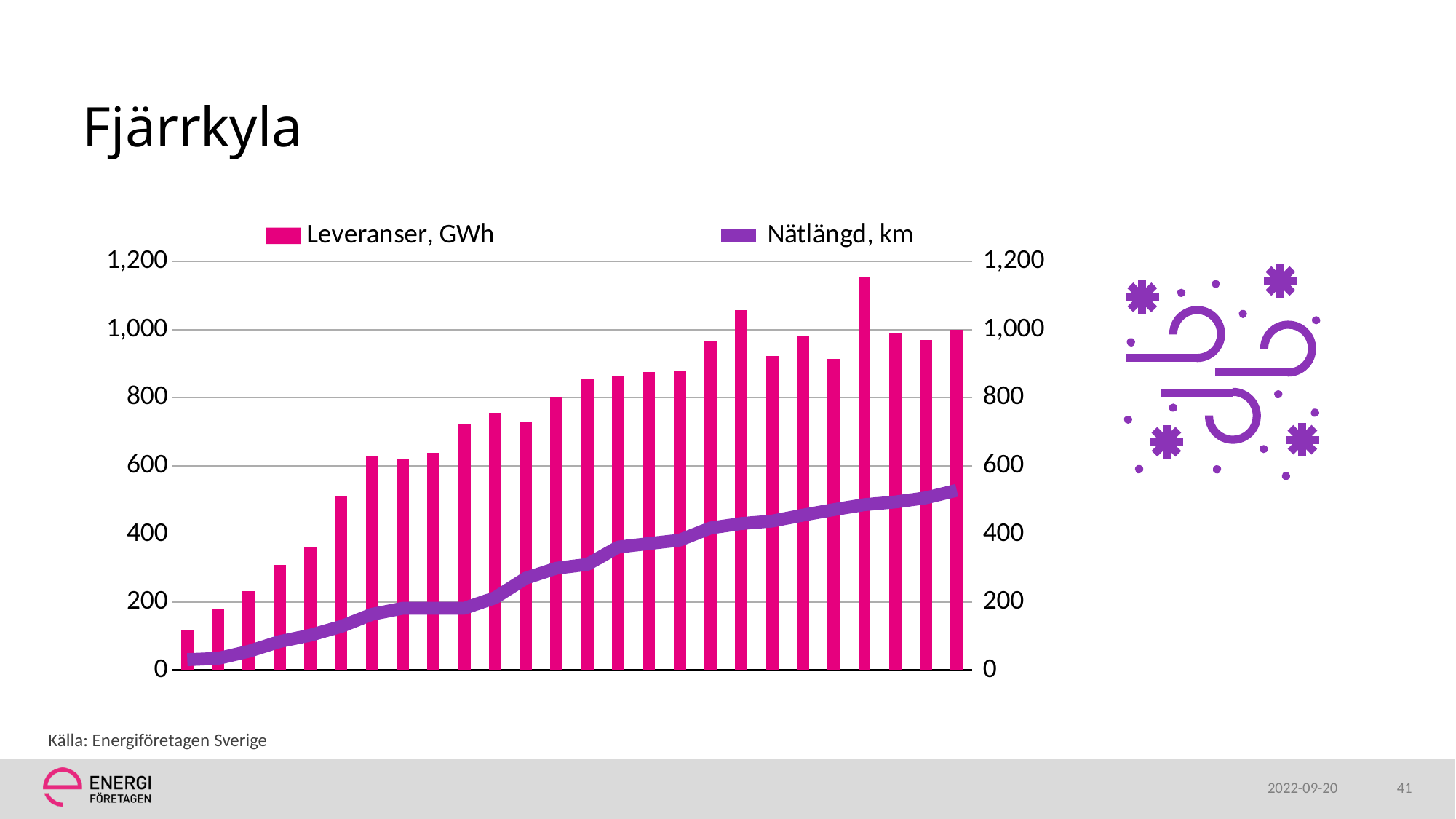
How many series does the legend list? 2 Is the final (rightmost) value of the Nätlängd, km line greater or less than 400? greater Do the Leveranser, GWh bars generally rise or fall from left to right? Rise Is the tallest Leveranser, GWh bar greater or less than 1,100? greater What kind of chart is shown on the slide? A bar chart combined with a line Is the first (leftmost) Leveranser, GWh bar greater or less than 200? less What is the title of the slide containing the chart? Fjärrkyla Does the Nätlängd, km line rise or fall from left to right? Rise What are the two series named in the legend? Leveranser, GWh and Nätlängd, km What is the highest value shown on the vertical axis? 1,200